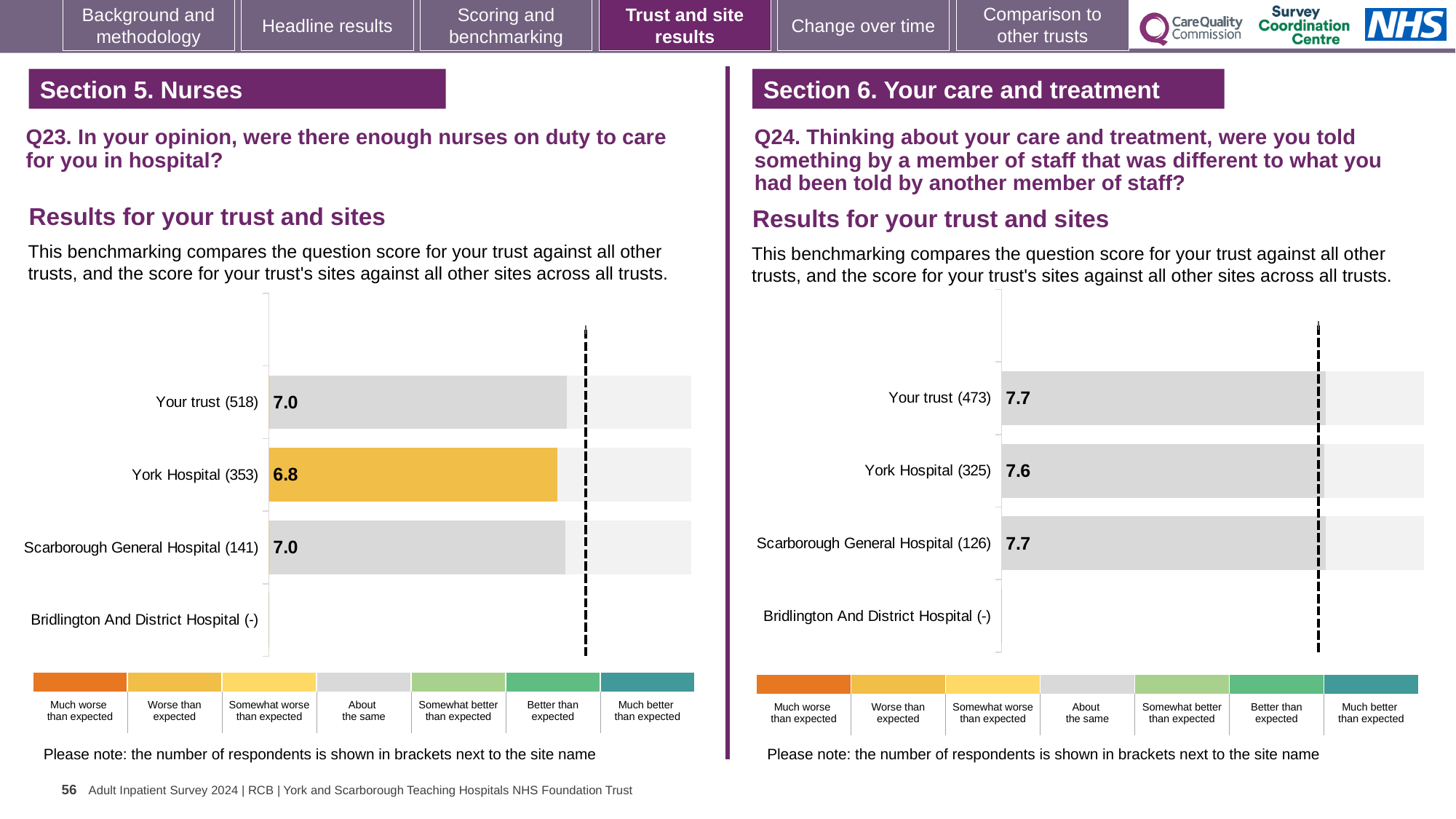
In the Q23 chart on the left, which benchmark category does the colour of the York Hospital bar correspond to? Worse than expected In the Q23 chart on the left, what is the score for York Hospital? 6.8 In the Q23 chart on the left, how many respondents are shown in brackets for York Hospital? 353 In the Q23 chart on the left, what is the difference between the score for Scarborough General Hospital and the score for York Hospital? 0.2 In the Q24 chart on the right, which is larger: the score for Your trust or the score for York Hospital? Your trust In the Q24 chart on the right, what is the score for Your trust? 7.7 In the Q23 chart on the left, what is the score for Your trust? 7.0 What type of chart is used for the Q24 results on the right? Bar chart In the Q24 chart on the right, what is the score for York Hospital? 7.6 In the Q24 chart on the right, what is the score for Scarborough General Hospital? 7.7 In the Q23 chart on the left, which site has the lowest score among those with a plotted value? York Hospital In the Q24 chart on the right, how many site/trust categories are listed on the vertical axis? 4